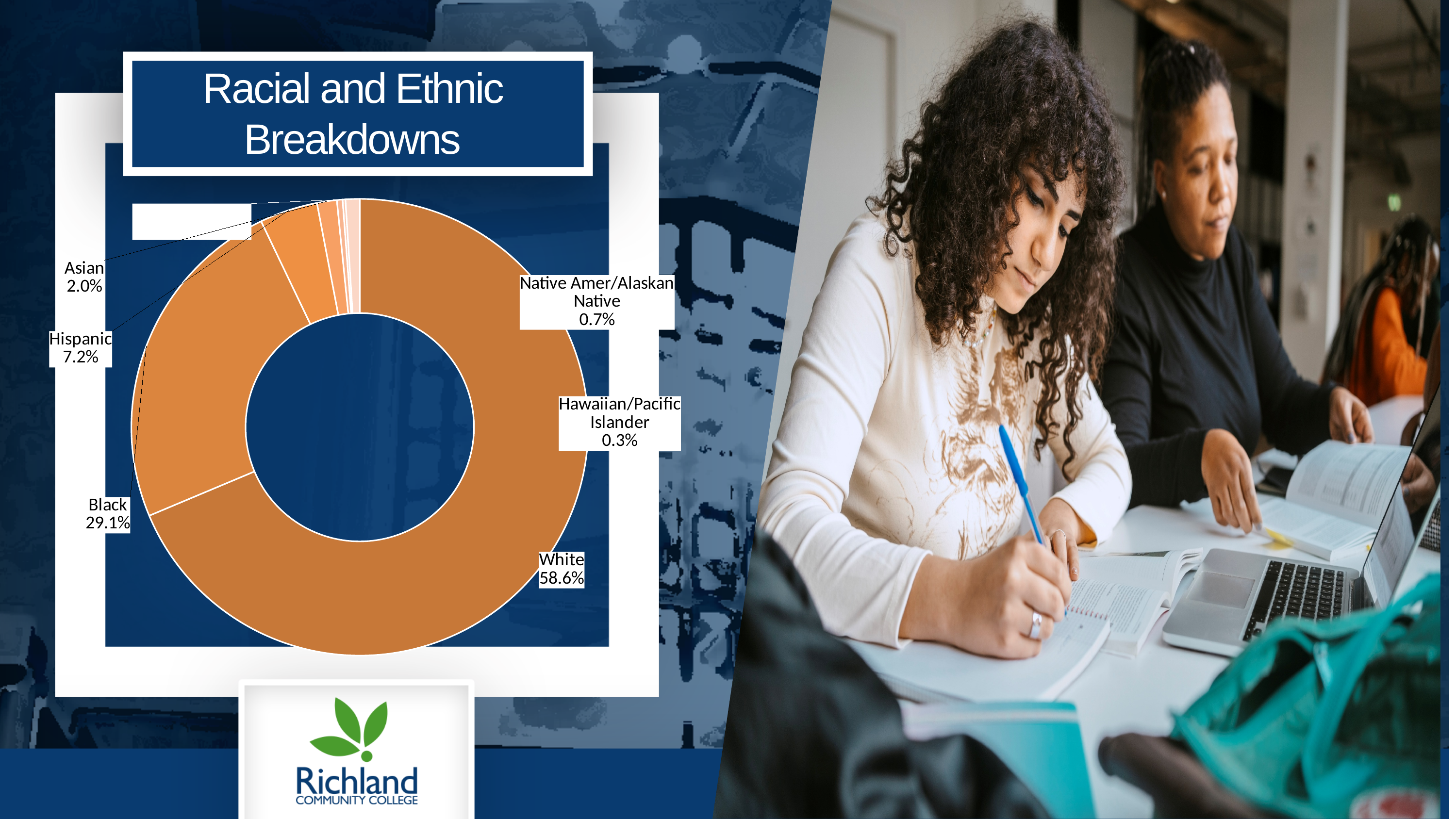
Which is larger, the Hispanic slice or the Asian slice? Hispanic What percentage is labelled for Native Amer/Alaskan Native? 0.7% What kind of chart is shown on the slide? doughnut chart Which labelled group has the largest share of the chart? White What is the value labelled for Hispanic? 7.2% What percentage is shown for Black in the chart? 29.1% What percentage is shown for Asian? 2.0% What percentage does the White slice represent in the Racial and Ethnic Breakdowns chart? 58.6% What is the title of the chart? Racial and Ethnic Breakdowns What percentage is labelled for Hawaiian/Pacific Islander? 0.3% What is the difference in percentage points between the White and Black slices? 29.5 Which labelled group has the smallest share of the chart? Hawaiian/Pacific Islander